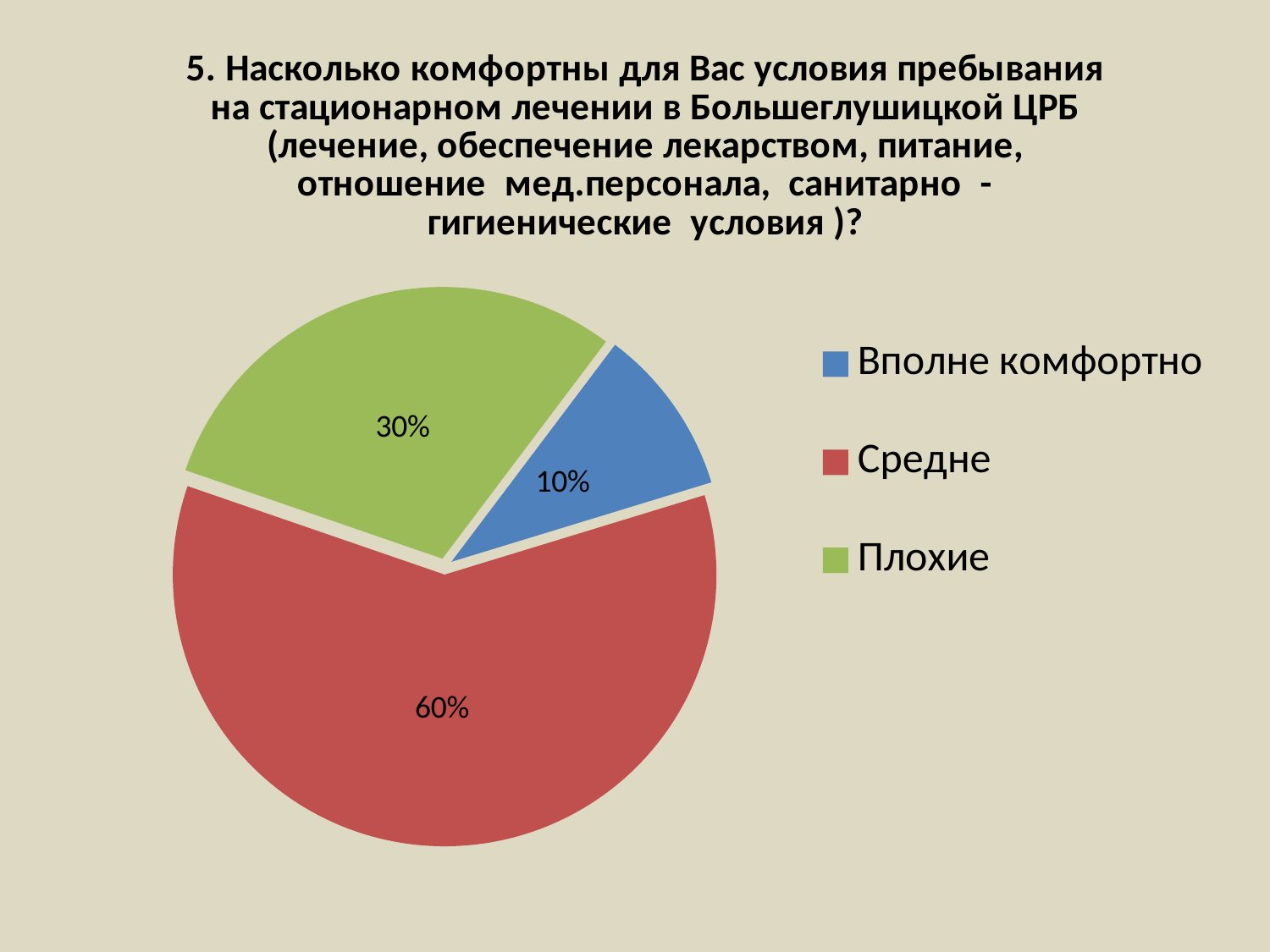
What colour is the slice for "Средне"? red What share of the pie does "Вполне комфортно" take? 10% How many entries does the legend list? 3 What kind of chart is shown on the slide? pie chart What is the difference in percentage points between "Плохие" and "Вполне комфортно"? 20 What share of the pie does "Средне" take? 60% Which category has the smallest slice of the pie? Вполне комфортно What is the difference in percentage points between "Средне" and "Плохие"? 30 How many categories does the pie chart have? 3 What share of the pie does "Плохие" take? 30% Which is larger, the slice for "Плохие" or the slice for "Вполне комфортно"? Плохие Which category has the largest slice of the pie? Средне